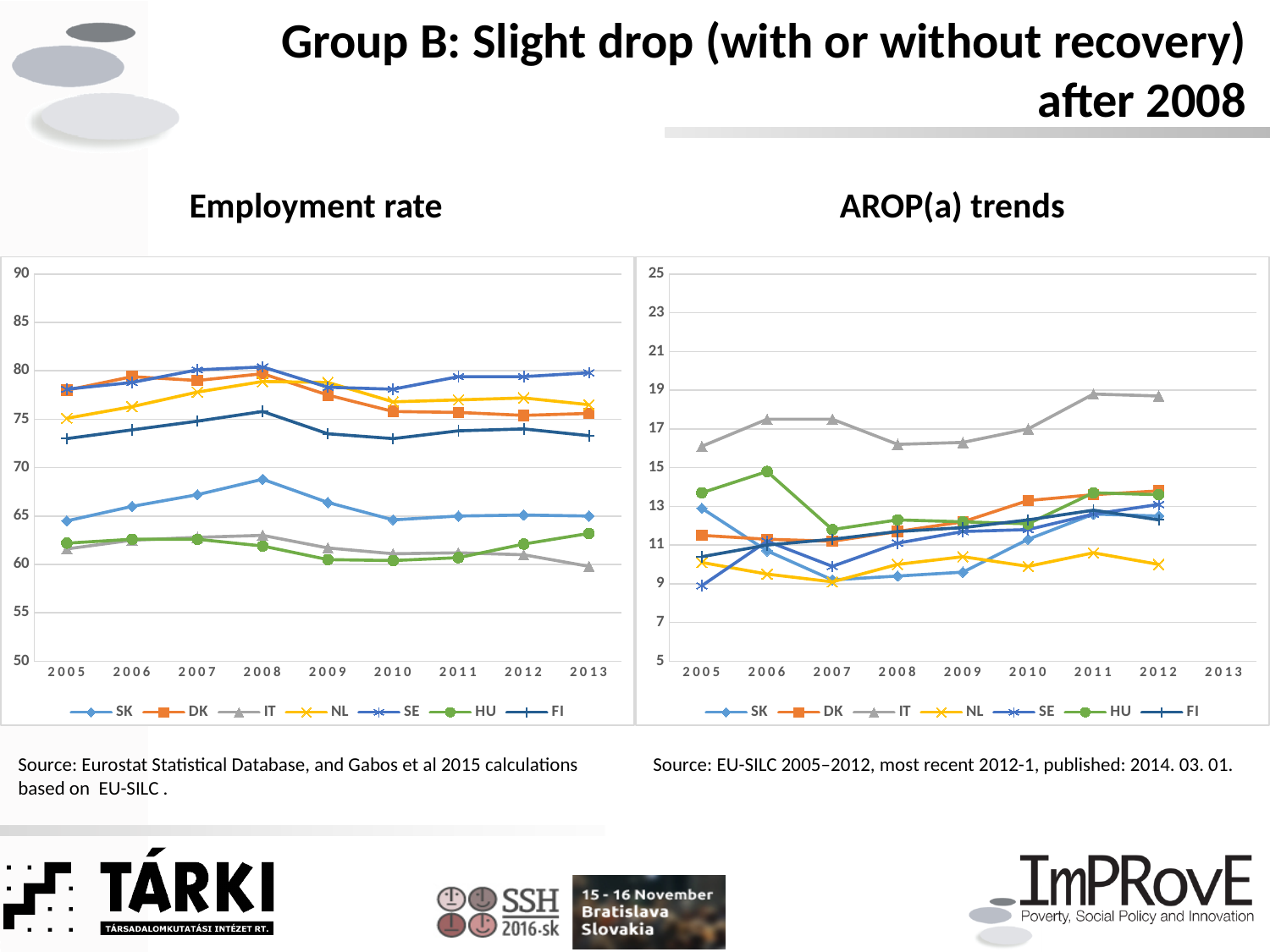
What kind of chart is the Employment rate chart? line chart In the Employment rate chart, is the value for FI in 2005 greater or less than 70? greater In the AROP(a) trends chart, which is larger in 2005, the value for IT or the value for SK? IT In the Employment rate chart, is the value for SK in 2008 greater or less than 65? greater In the AROP(a) trends chart, is the value for SK in 2007 greater or less than 11? less In the Employment rate chart, which series has the highest value in 2013? SE In the AROP(a) trends chart, which series has the highest value in 2012? IT How many series does the legend of the AROP(a) trends chart list? 7 In the Employment rate chart, which series has the lowest value in 2013? IT How many years are shown on the x axis of the Employment rate chart? 9